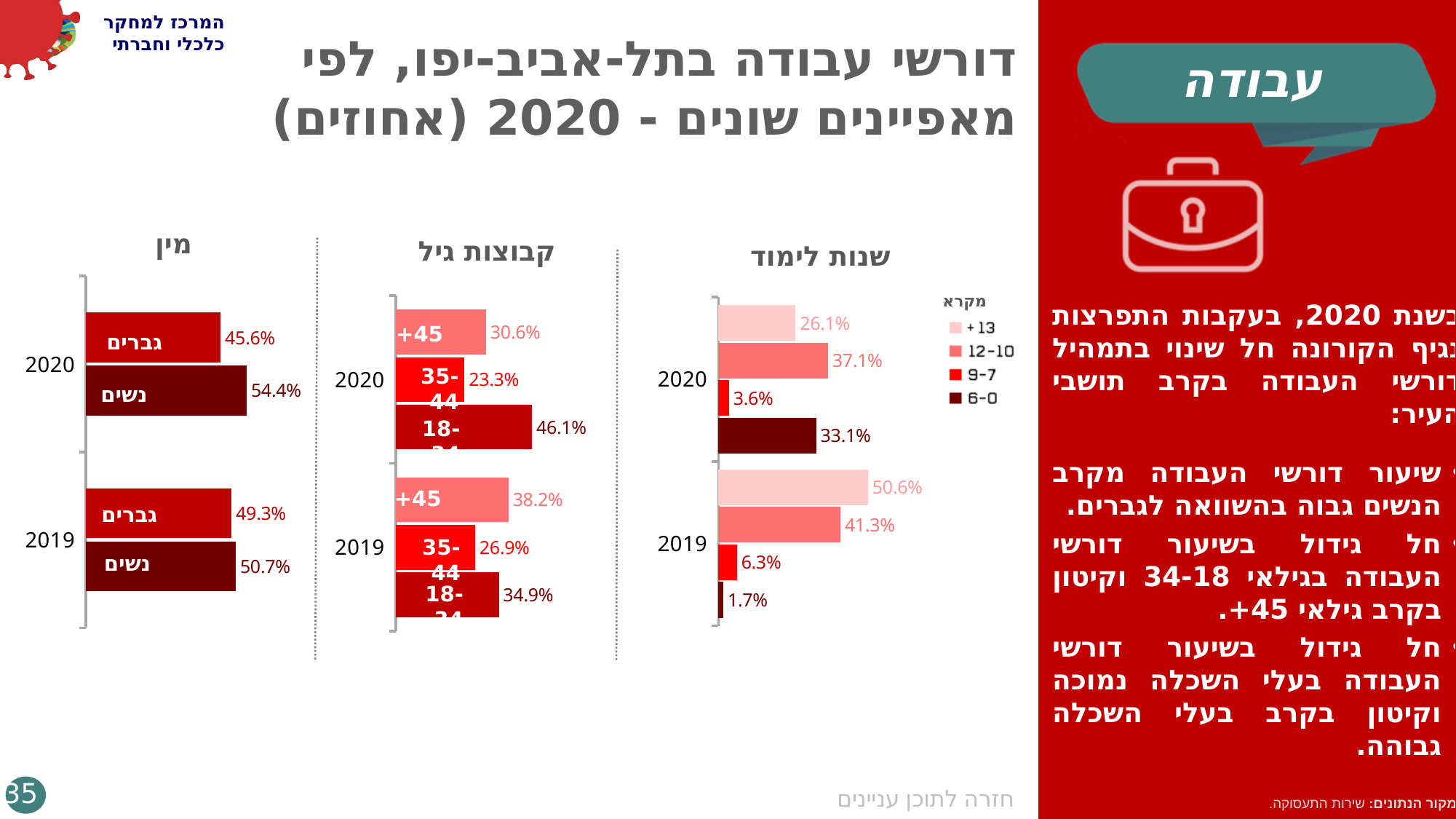
In the 'שנות לימוד' chart, what is the value for 10-12 in 2020? 37.1% How many series does the legend of the 'שנות לימוד' chart list? 4 In the 'קבוצות גיל' chart, what is the value for +45 in 2019? 38.2% In the 'קבוצות גיל' chart, which is larger in 2019: +45 or 18-34? +45 In the 'שנות לימוד' chart, what is the difference between 13+ in 2019 and 13+ in 2020? 24.5% In the 'שנות לימוד' chart, what is the value for 13+ in 2019? 50.6% In the 'שנות לימוד' chart, which category has the lowest value in 2019? 0-6 In the 'מין' chart, what is the difference between נשים and גברים in 2020? 8.8% What kind of chart is the 'מין' chart? Bar chart In the 'קבוצות גיל' chart, which age group has the highest value in 2020? 18-34 In the 'מין' chart, what is the value for נשים in 2020? 54.4% In the 'מין' chart, what is the value for גברים in 2019? 49.3%